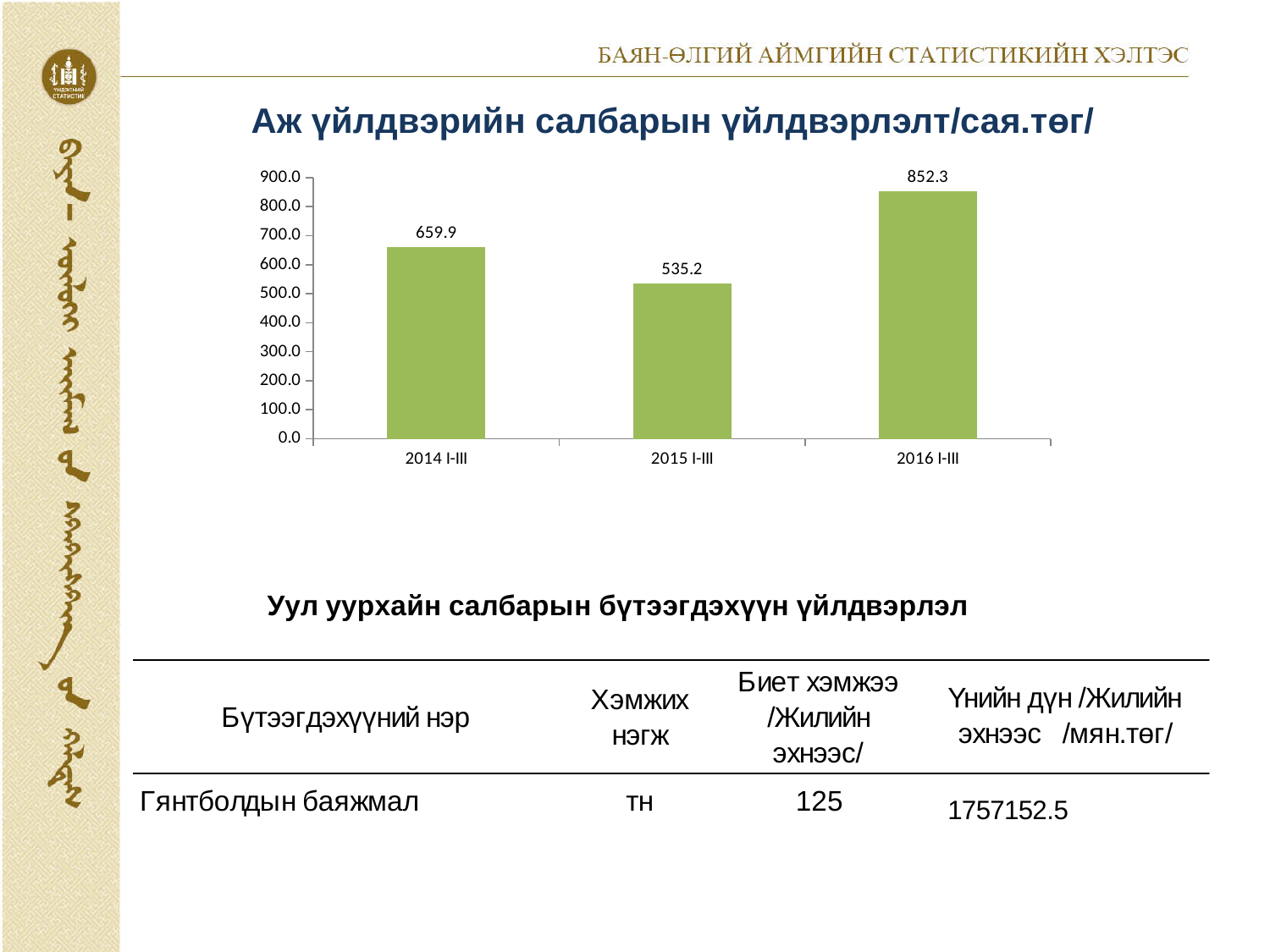
What is the difference between the values for 2014 I-III and 2015 I-III? 124.7 What is the value for 2015 I-III? 535.2 What is the difference between the values for 2016 I-III and 2015 I-III? 317.1 Which period has the highest value? 2016 I-III How many periods are shown on the x axis? 3 What is the value for 2014 I-III? 659.9 Which is larger, the value for 2014 I-III or the value for 2016 I-III? 2016 I-III What is the value for 2016 I-III? 852.3 What kind of chart is shown on the slide? bar chart Is the value for 2015 I-III greater or less than 600.0? less What is the title of the chart? Аж үйлдвэрийн салбарын үйлдвэрлэлт/сая.төг/ Which period has the lowest value? 2015 I-III